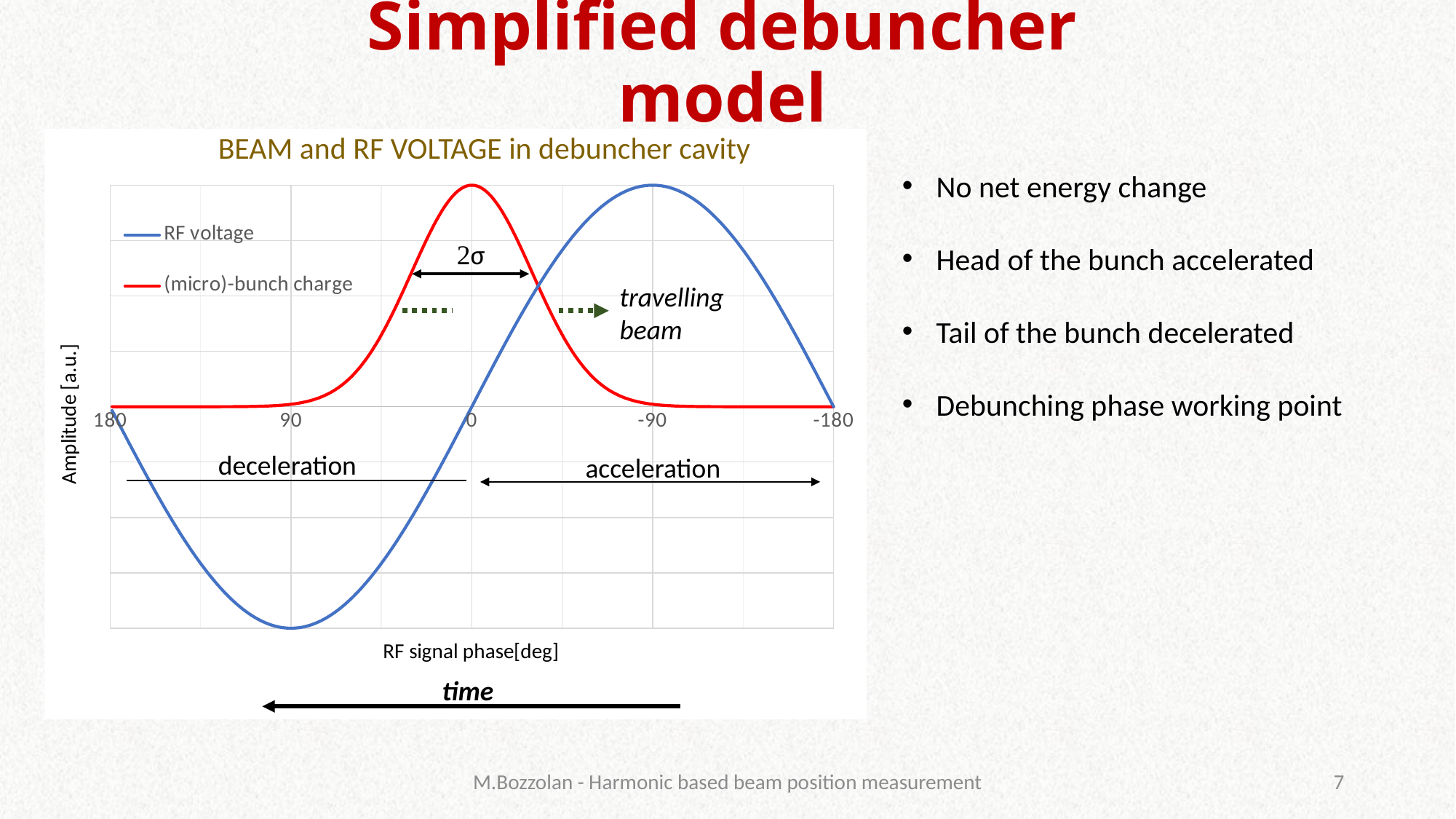
What colour is the RF voltage line in the chart? blue At which RF signal phase does the RF voltage reach its maximum? -90 Moving along the x axis from phase 90 to phase -90, does the RF voltage rise or fall? rise At RF signal phase -90, which series has the higher amplitude, RF voltage or (micro)-bunch charge? RF voltage At RF signal phase 0, which series has the higher amplitude, RF voltage or (micro)-bunch charge? (micro)-bunch charge Moving along the x axis from phase 0 to phase -90, does the (micro)-bunch charge rise or fall? fall At which RF signal phase does the RF voltage reach its minimum? 90 What kind of chart is shown on the slide? line chart What is the title of the chart? BEAM and RF VOLTAGE in debuncher cavity How many series does the chart legend list? 2 At which RF signal phase does the (micro)-bunch charge reach its maximum? 0 How many labelled tick values are shown on the x axis of the chart? 5